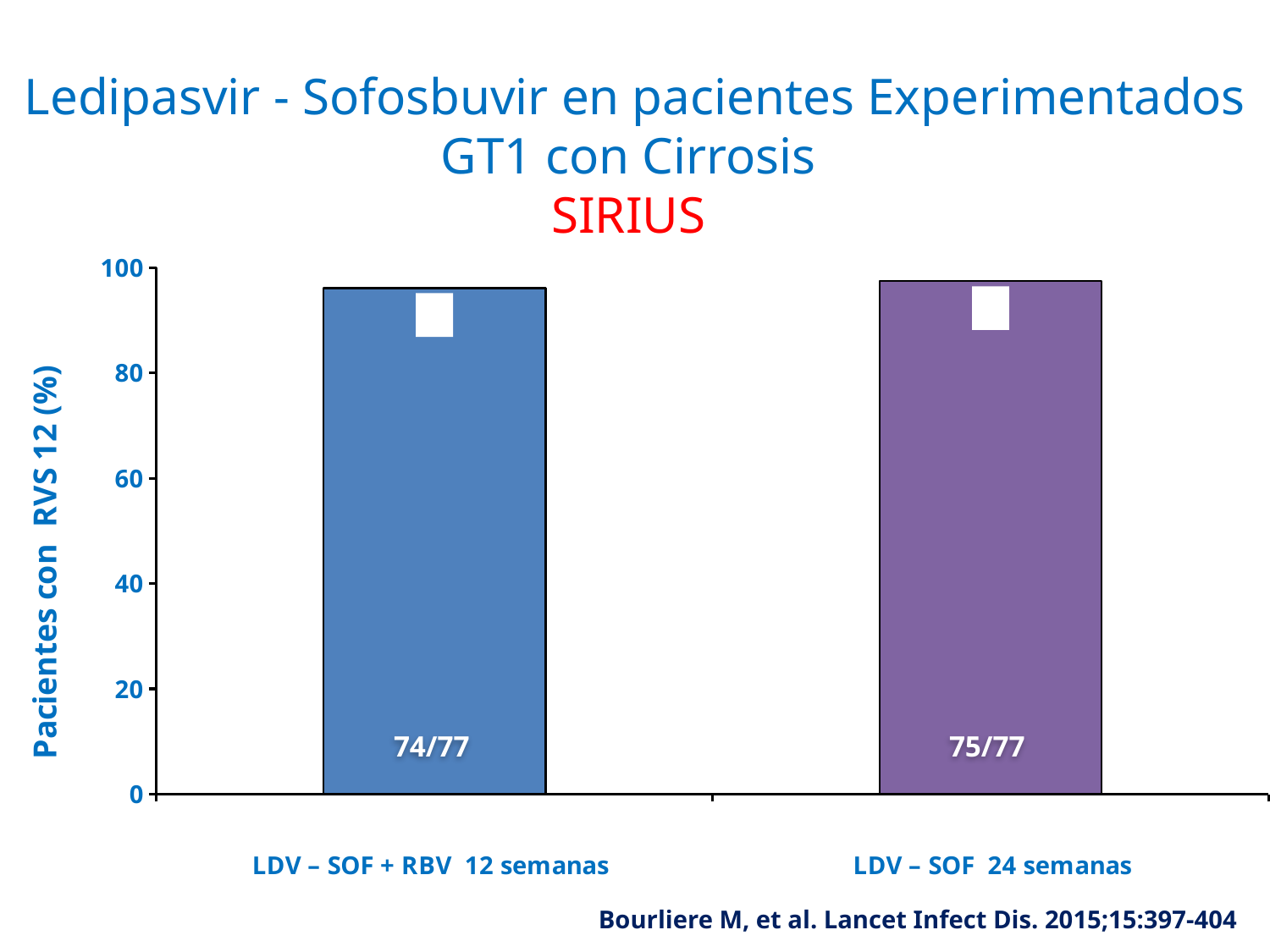
What is the highest tick value shown on the y axis? 100 What label is printed inside the bar for LDV – SOF + RBV 12 semanas? 74/77 What is the label of the y axis? Pacientes con RVS 12 (%) Is the value for LDV – SOF 24 semanas greater or less than 80? greater Is the value for LDV – SOF + RBV 12 semanas greater or less than 100? less Based on the printed fractions, which group had more patients with RVS 12: LDV – SOF + RBV 12 semanas or LDV – SOF 24 semanas? LDV – SOF 24 semanas How many bars are plotted in the chart? 2 What label is printed inside the bar for LDV – SOF 24 semanas? 75/77 What kind of chart is shown on the slide? bar chart Is the value for LDV – SOF + RBV 12 semanas greater or less than 80? greater What is the name of the study shown in red under the title? SIRIUS